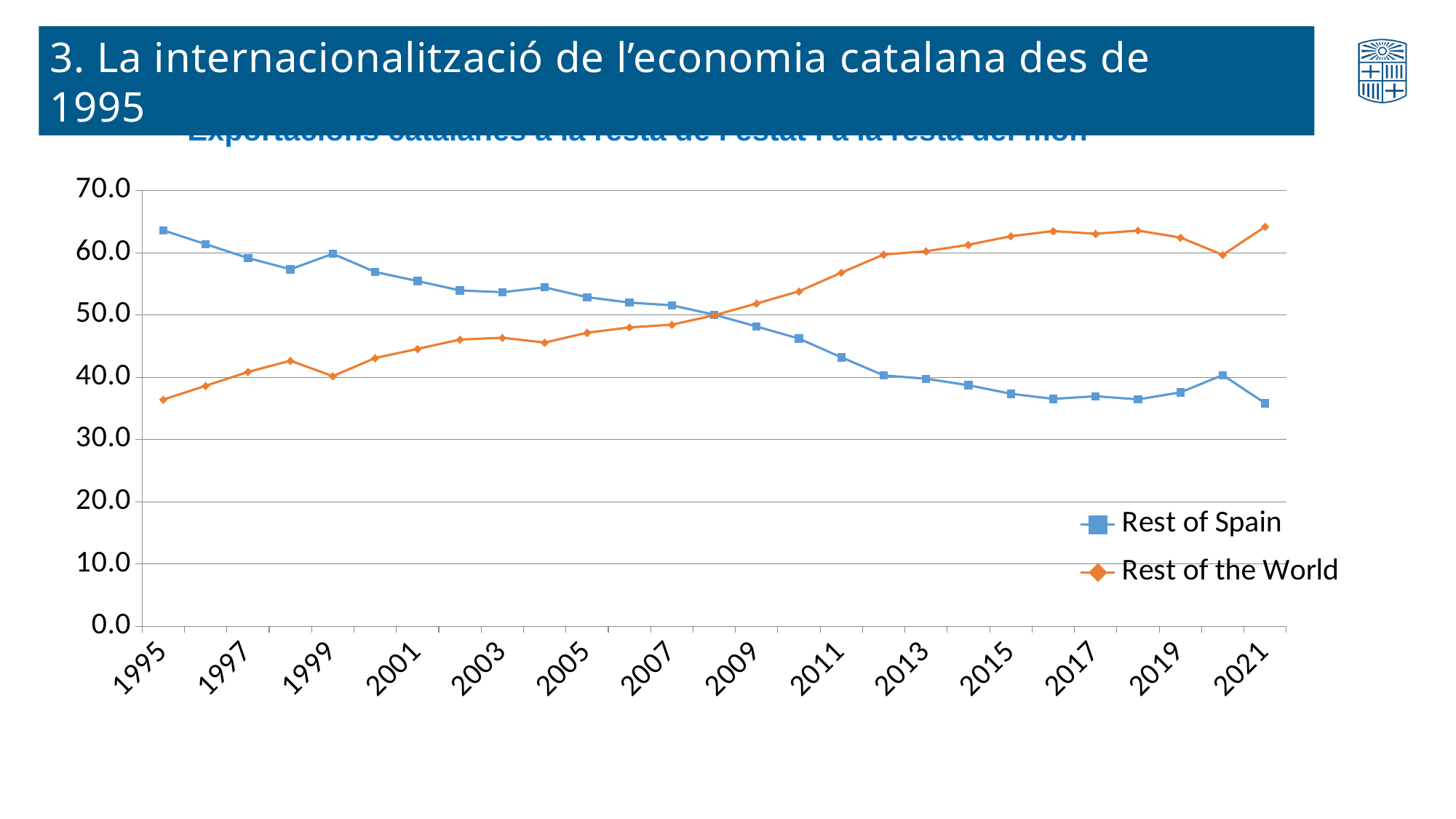
In 2021, which series has the higher value, Rest of Spain or Rest of the World? Rest of the World Which series is shown in orange in the legend? Rest of the World Does the Rest of the World series rise or fall overall from 1995 to 2021? Rise In 1995, which series has the higher value, Rest of Spain or Rest of the World? Rest of Spain Is the value for Rest of the World in 2021 greater or less than 60.0? greater What kind of chart is shown on the slide? Line chart In which year does the Rest of Spain series reach its highest value? 1995 Is the value for Rest of the World in 1995 greater or less than 40.0? less Is the value for Rest of Spain in 2013 greater or less than 50.0? less Does the Rest of Spain series rise or fall overall from 1995 to 2021? Fall How many series does the legend list? 2